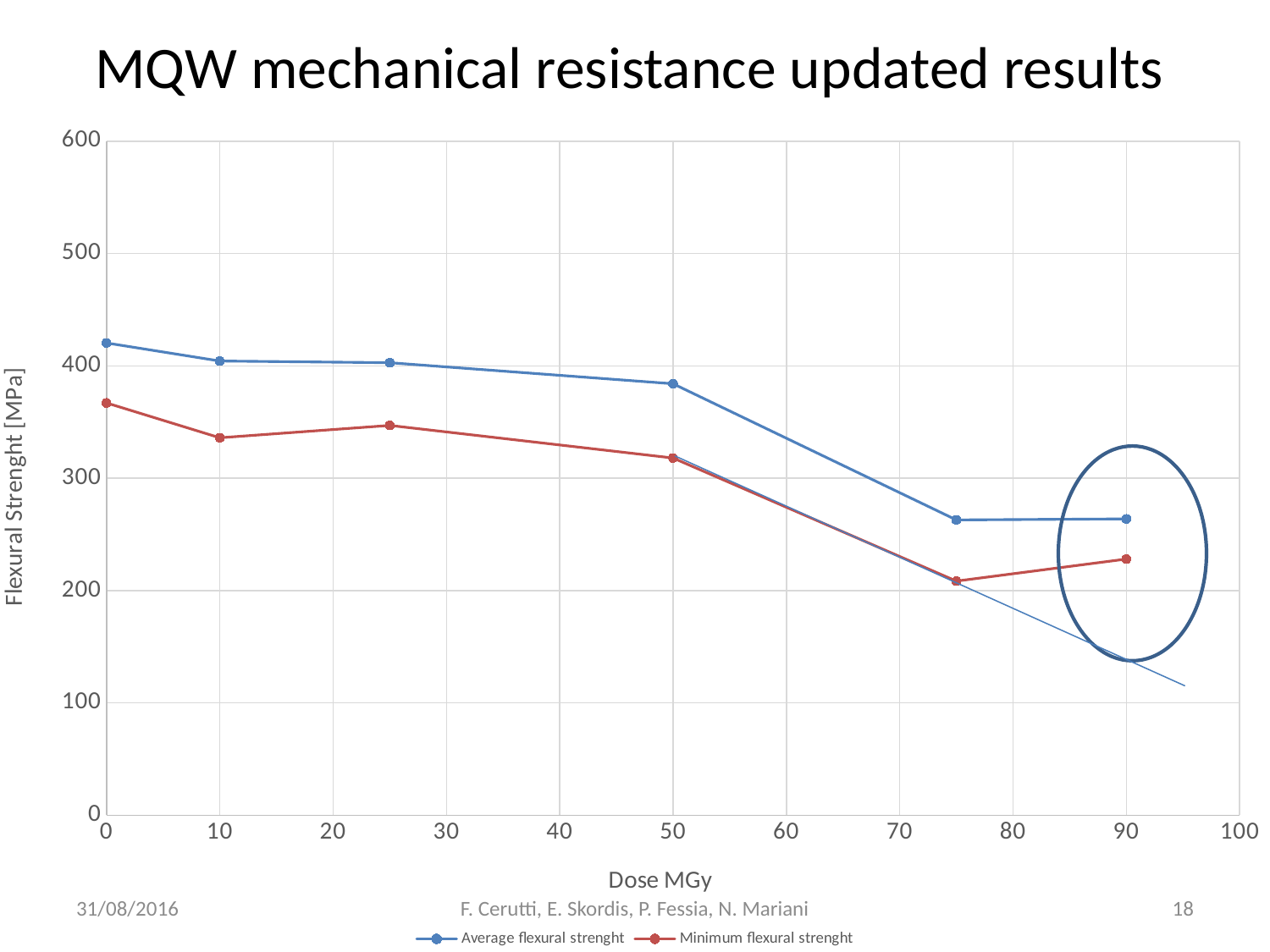
Does the Average flexural strenght generally rise or fall as the dose increases from 0 to 90 MGy? fall Is the Average flexural strenght at a dose of 0 MGy greater or less than 400? greater What kind of chart is shown on the slide? line chart What is the label of the y axis? Flexural Strenght [MPa] How many data points are plotted for the Average flexural strenght series? 6 Is the Average flexural strenght at a dose of 75 MGy greater or less than 300? less At a dose of 50 MGy, which is larger: the Average flexural strenght or the Minimum flexural strenght? Average flexural strenght At which dose is the Average flexural strenght highest? 0 MGy Is the Minimum flexural strenght at a dose of 50 MGy greater or less than 400? less At which dose is the Minimum flexural strenght lowest? 75 MGy How many series does the legend list? 2